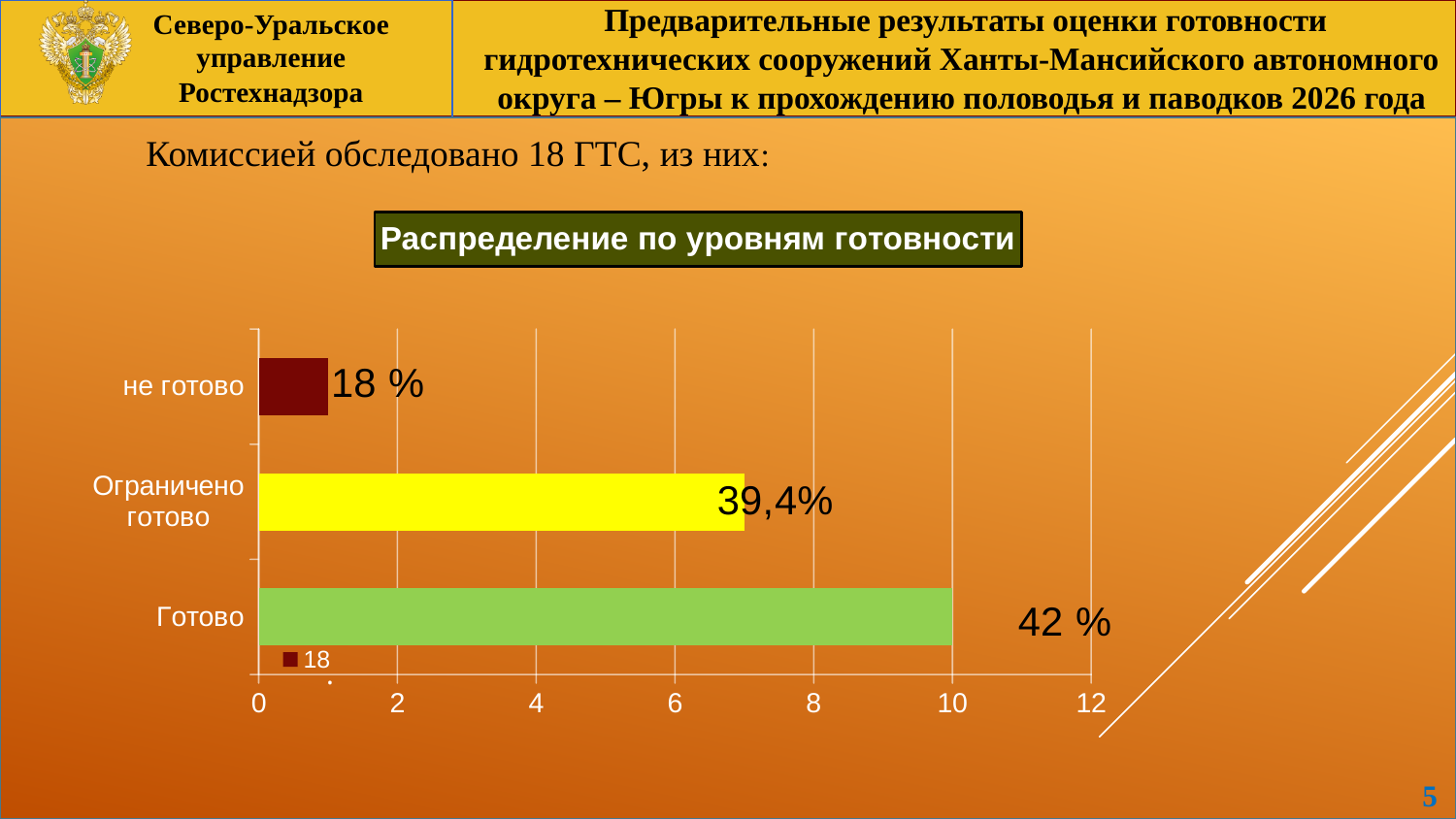
What kind of chart is shown on the slide? bar chart Which category has the shortest bar? не готово Is the bar for "Ограничено готово" greater or less than 6 on the x axis? greater How many categories are shown in the chart? 3 Which bar is longer, "Ограничено готово" or "не готово"? Ограничено готово What is the title of the chart? Распределение по уровням готовности What value on the x axis does the bar for "Готово" reach? 10 What data label is shown for the category "не готово"? 18 % What data label is shown for the category "Ограничено готово"? 39,4% What data label is shown for the category "Готово"? 42 % Is the bar for "не готово" greater or less than 2 on the x axis? less Which category has the longest bar? Готово